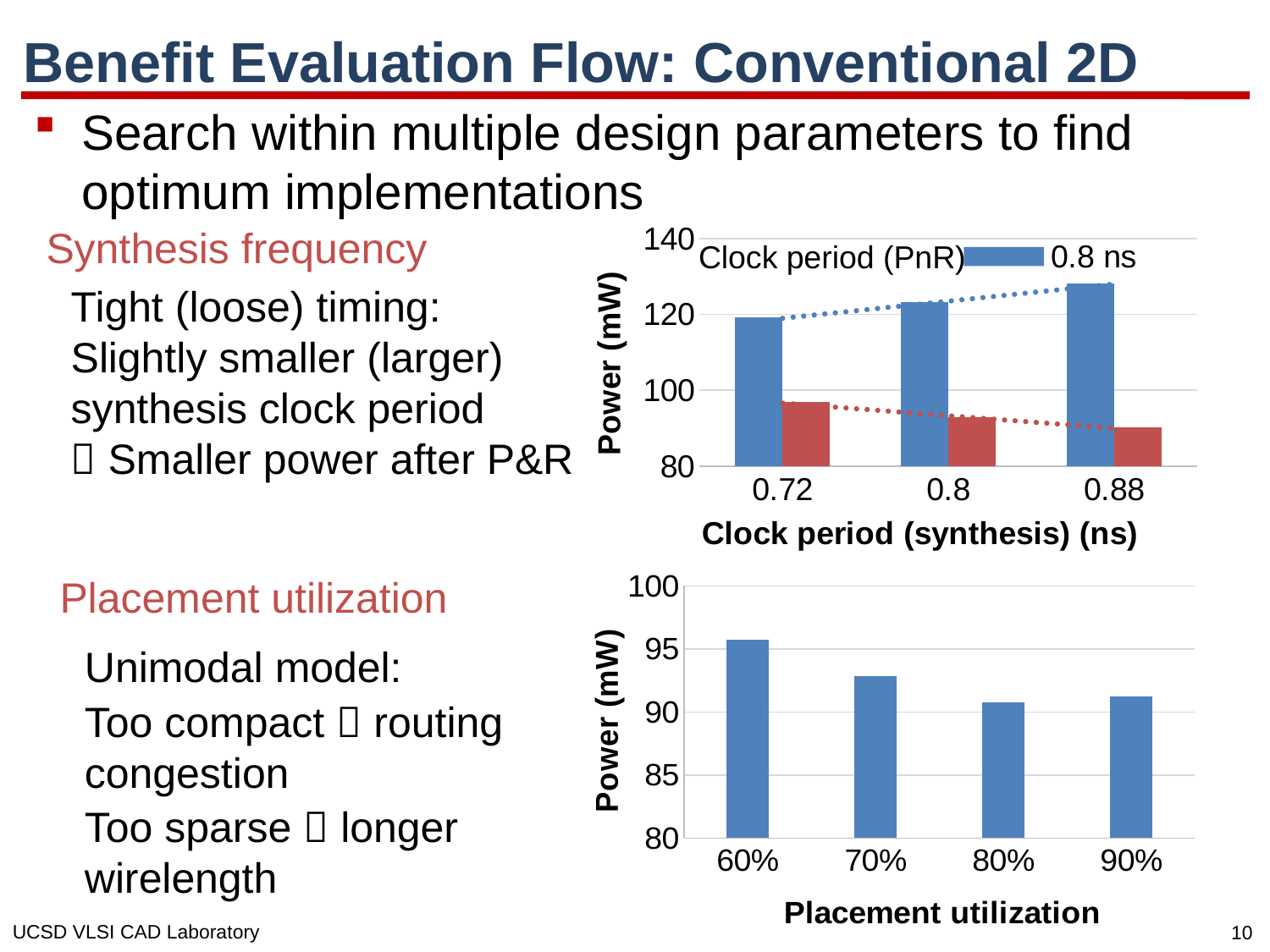
In the bottom chart (Placement utilization), which has the larger power, 60% or 70%? 60% What is the x-axis title of the bottom chart? Placement utilization In the bottom chart (Placement utilization), is the power for 70% greater or less than 95? less In the bottom chart (Placement utilization), is the power for 60% greater or less than 95? greater What kind of chart is the bottom chart (Placement utilization)? bar chart In the bottom chart (Placement utilization), which placement utilization has the highest power? 60% In the top chart (Clock period (synthesis)), is the red bar value for 0.88 greater or less than 100? less In the top chart (Clock period (synthesis)), do the blue bars rise or fall as the synthesis clock period increases? rise In the top chart (Clock period (synthesis)), how many synthesis clock period categories are shown on the x axis? 3 What is the y-axis title of the top chart? Power (mW) In the bottom chart (Placement utilization), how many placement utilization categories are shown on the x axis? 4